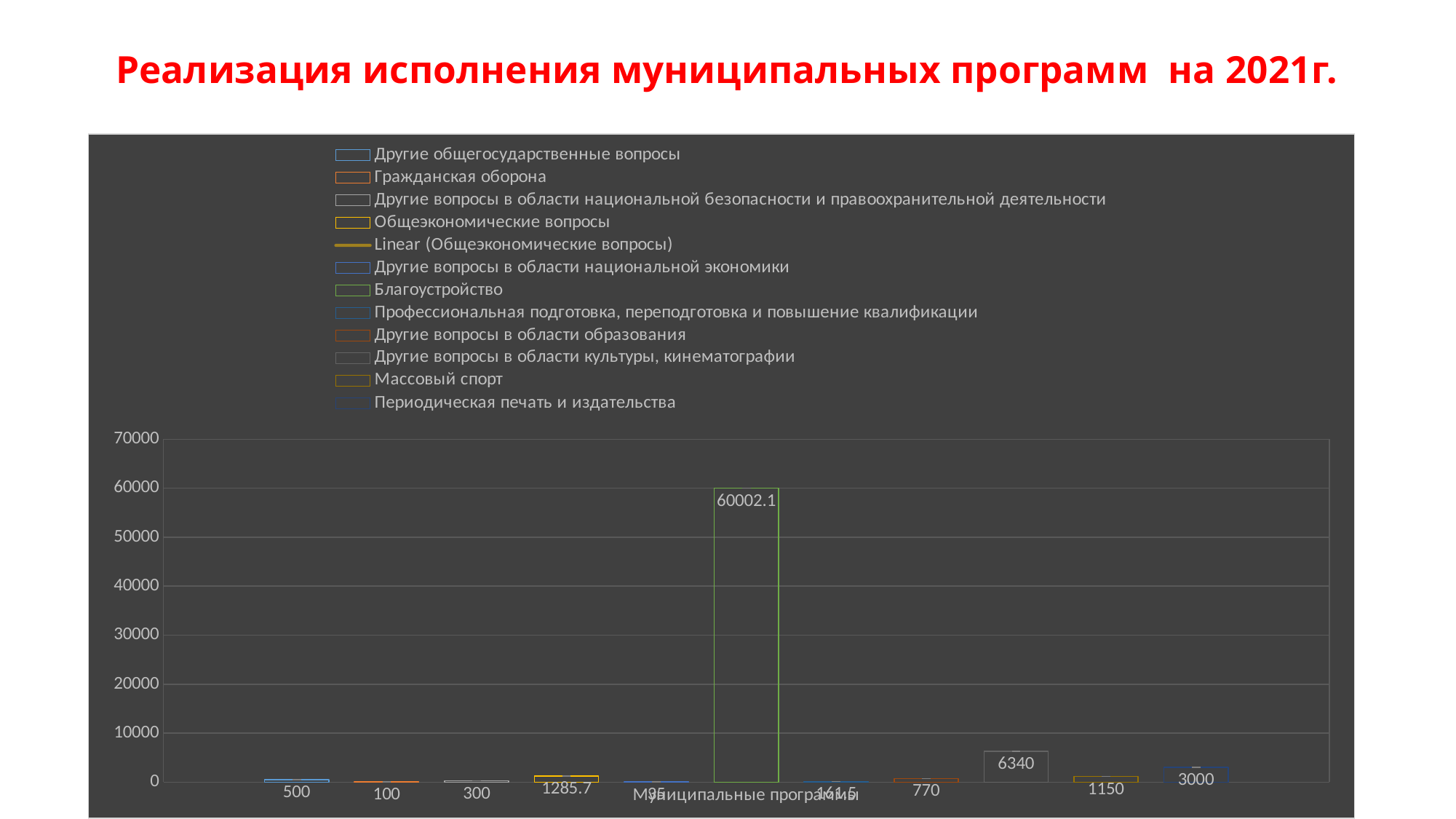
What is the value for Гражданская оборона? 100 Is the value for Благоустройство greater or less than 50000? greater What is the value for Другие вопросы в области культуры, кинематографии? 6340 What is the label shown on the x axis of the chart? Муниципальные программы What is the value for Периодическая печать и издательства? 3000 What is the value for Массовый спорт? 1150 How many entries does the legend list? 12 What is the difference between the values for Другие вопросы в области культуры, кинематографии and Периодическая печать и издательства? 3340 What kind of chart is shown on the slide? bar chart What is the value for Благоустройство? 60002.1 Which is larger: the value for Общеэкономические вопросы or the value for Массовый спорт? Общеэкономические вопросы Which series has the highest value in the chart? Благоустройство